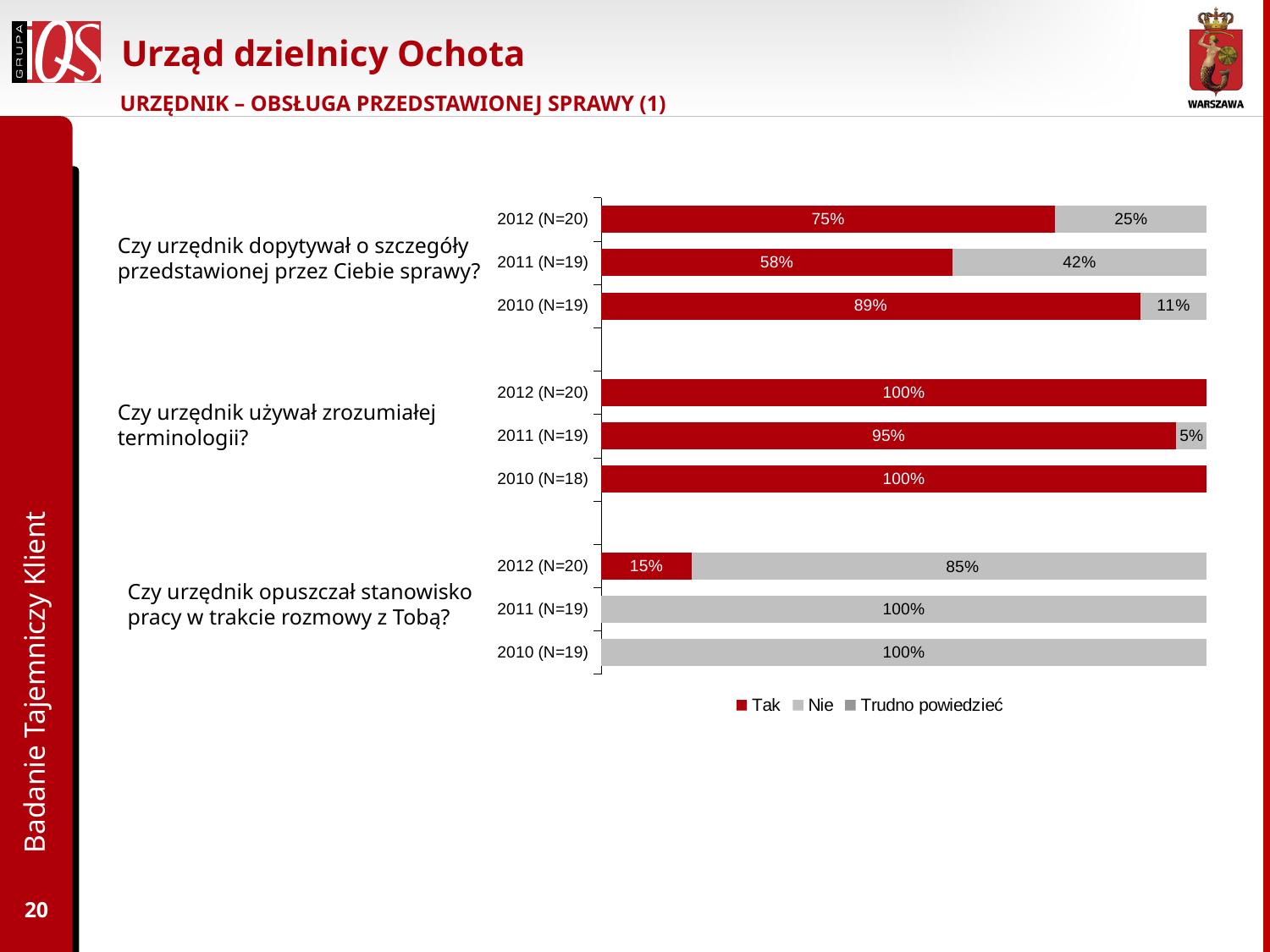
For the question 'Czy urzędnik dopytywał o szczegóły przedstawionej przez Ciebie sprawy?', which year had the lowest 'Tak' share? 2011 (N=19) What kind of chart is shown on the slide? Stacked bar chart How many bars are plotted in total on the chart? 9 What percentage answered 'Tak' for 2011 (N=19) on the question 'Czy urzędnik używał zrozumiałej terminologii?' 95% For 'Czy urzędnik dopytywał o szczegóły przedstawionej przez Ciebie sprawy?', is the 'Nie' share larger in 2012 (N=20) or 2011 (N=19)? 2011 (N=19) Which colour represents 'Tak' in the legend? Red What percentage answered 'Tak' for 2012 (N=20) on the question 'Czy urzędnik dopytywał o szczegóły przedstawionej przez Ciebie sprawy?' 75% What percentage answered 'Nie' for 2011 (N=19) on the question 'Czy urzędnik dopytywał o szczegóły przedstawionej przez Ciebie sprawy?' 42% What percentage answered 'Nie' for 2012 (N=20) on the question 'Czy urzędnik opuszczał stanowisko pracy w trakcie rozmowy z Tobą?' 85% How many series does the legend list? 3 What is the difference between the 'Tak' share in 2010 (N=19) and 2011 (N=19) for 'Czy urzędnik dopytywał o szczegóły przedstawionej przez Ciebie sprawy?' 31 percentage points For the question 'Czy urzędnik dopytywał o szczegóły przedstawionej przez Ciebie sprawy?', which year had the highest 'Tak' share? 2010 (N=19)